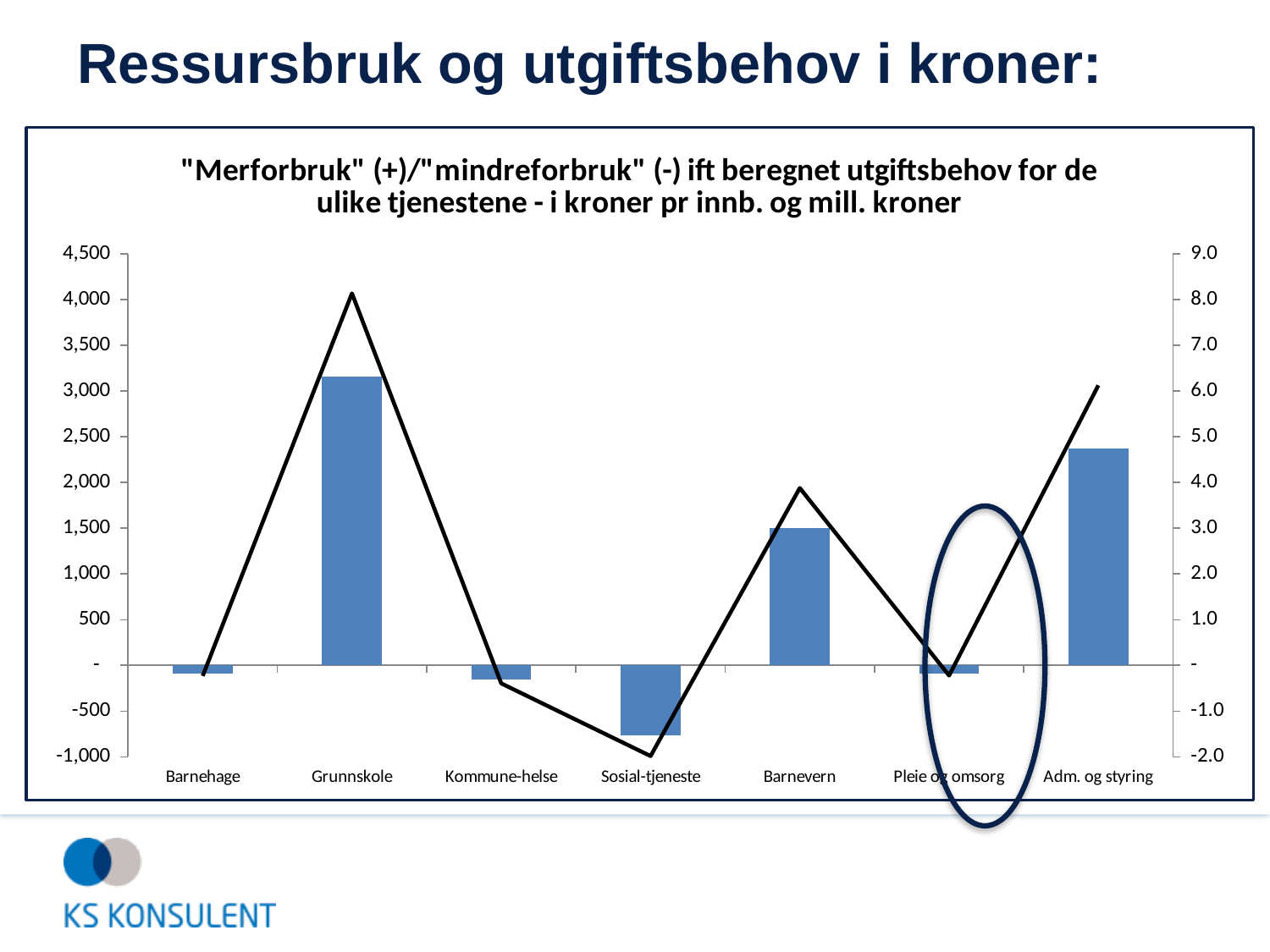
Is the bar value for Grunnskole greater or less than 3,000 on the left axis? greater Does the line rise or fall from Pleie og omsorg to Adm. og styring? rise Which category has the highest bar in the chart? Grunnskole Which has the larger bar, Barnehage or Grunnskole? Grunnskole How many categories are shown on the x axis of the chart? 7 Is the bar value for Sosial-tjeneste greater or less than -500 on the left axis? less Is the bar value for Adm. og styring greater or less than 2,500 on the left axis? less Which has the larger bar, Barnevern or Adm. og styring? Adm. og styring Which category has the lowest (most negative) bar in the chart? Sosial-tjeneste Which category on the x axis is circled on the slide? Pleie og omsorg What kind of chart is shown on the slide? A combined bar and line chart